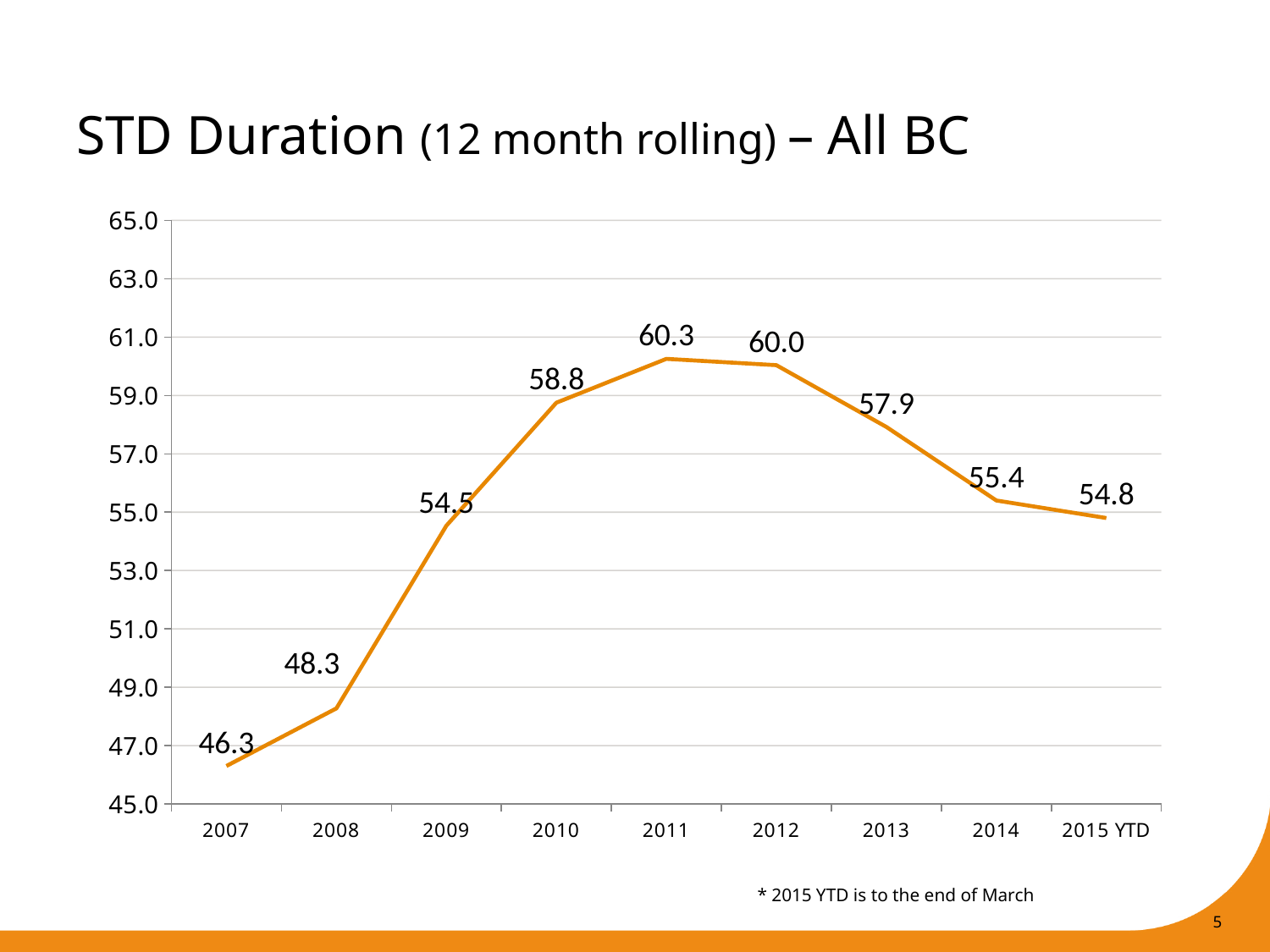
Which year has the lowest STD duration? 2007 What kind of chart is shown on the slide? line chart Does the STD duration rise or fall from 2012 to 2015 YTD? fall What is the STD duration value for 2007? 46.3 How many data points are plotted on the chart? 9 Is the STD duration value for 2010 greater or less than 57.0? greater What is the difference between the STD duration in 2013 and in 2014? 2.5 Which year has the highest STD duration? 2011 What is the difference between the STD duration in 2011 and in 2007? 14.0 What is the STD duration value for 2011? 60.3 What is the STD duration value for 2015 YTD? 54.8 Which is larger, the STD duration in 2009 or in 2014? 2014